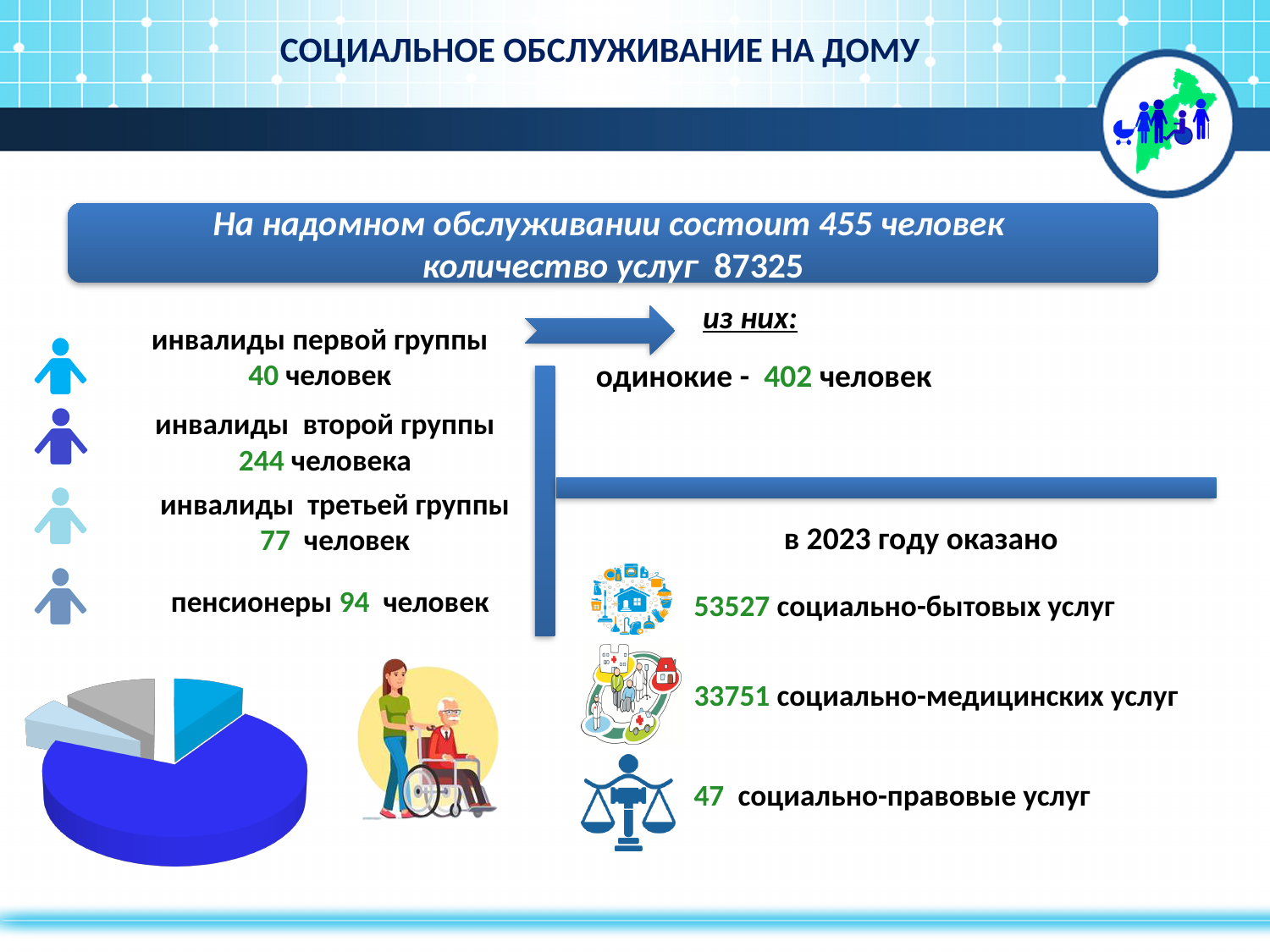
What kind of chart is shown at the bottom left of the slide? pie chart Which slice of the pie chart at the bottom left is the largest? the dark blue slice Is the pie chart at the bottom left of the slide drawn in 3D? Yes How many slices does the pie chart at the bottom left of the slide have? 4 Does the pie chart at the bottom left of the slide have a legend? No Is the dark blue slice of the pie chart larger or smaller than the gray slice? larger